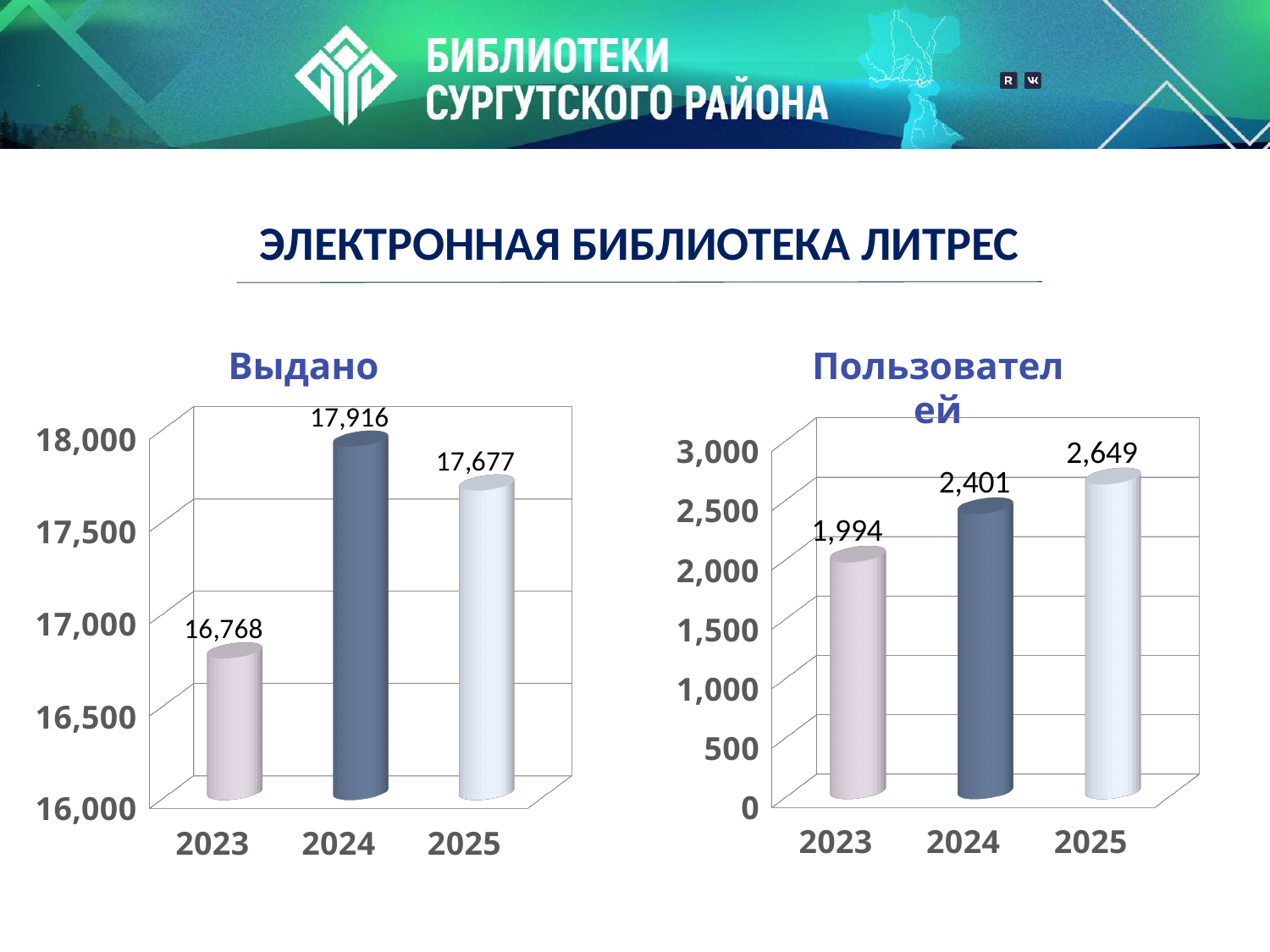
In the "Пользователей" chart, what is the value for 2025? 2,649 In the "Выдано" chart, what is the value for 2023? 16,768 How many years are shown in the "Выдано" chart? 3 In the "Выдано" chart, what is the value for 2024? 17,916 In the "Пользователей" chart, what is the difference between the values for 2025 and 2023? 655 In the "Выдано" chart, which year has the highest value? 2024 In the "Выдано" chart, which year has the lowest value? 2023 What kind of chart is the "Пользователей" chart? bar chart In the "Пользователей" chart, which year has the highest value? 2025 In the "Выдано" chart, what is the difference between the values for 2024 and 2025? 239 In the "Пользователей" chart, what is the value for 2023? 1,994 In the "Пользователей" chart, do the values rise or fall from 2023 to 2025? rise